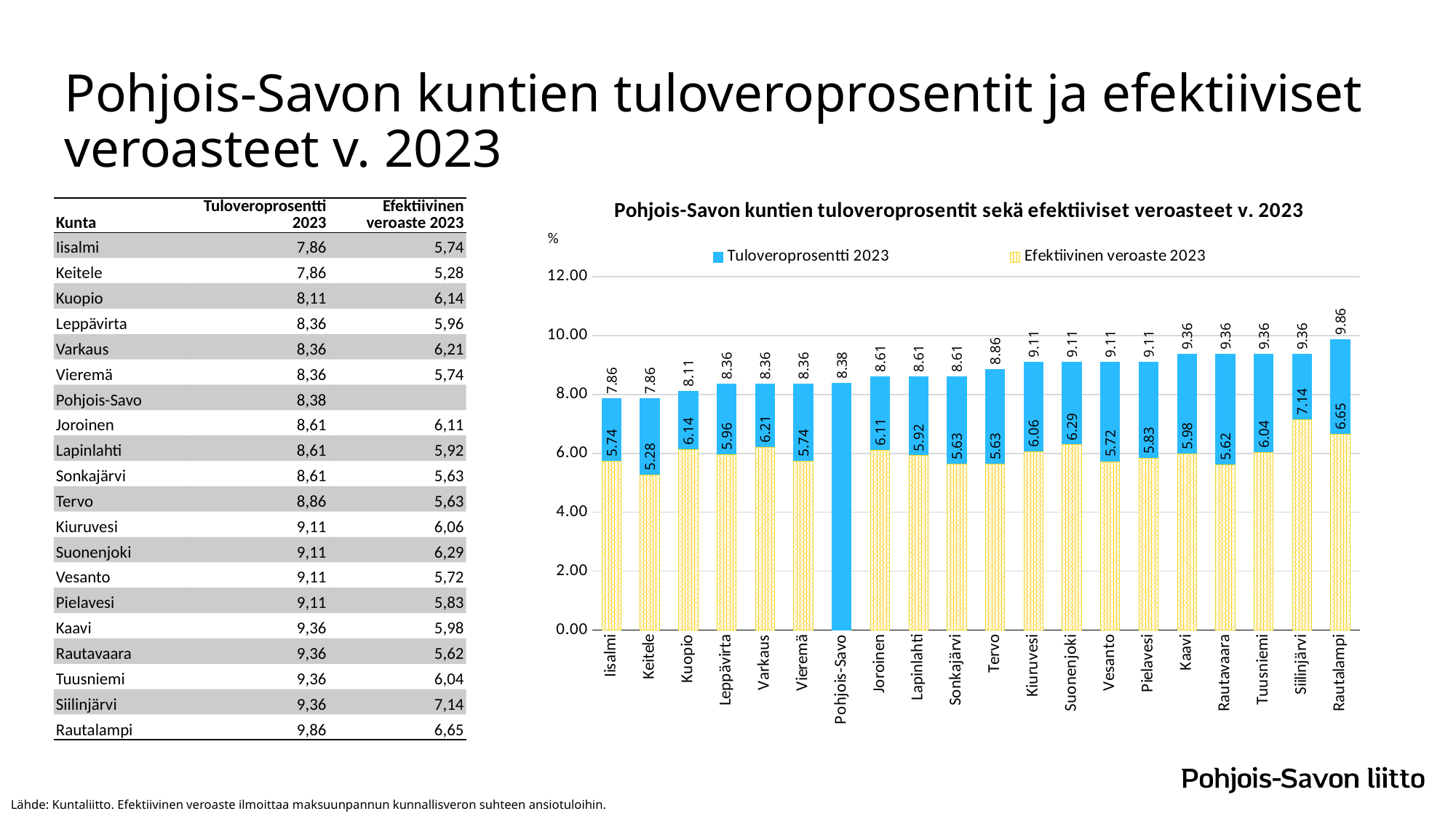
Which has a higher Efektiivinen veroaste 2023, Suonenjoki or Kiuruvesi? Suonenjoki What is the Efektiivinen veroaste 2023 value for Siilinjärvi in the chart? 7.14 Which category has the lowest Efektiivinen veroaste 2023 in the chart? Keitele What is the difference between the Tuloveroprosentti 2023 and the Efektiivinen veroaste 2023 for Rautalampi? 3.21 Which category has the highest Tuloveroprosentti 2023 in the chart? Rautalampi What type of chart is shown on the slide? bar chart Which category has the highest Efektiivinen veroaste 2023 in the chart? Siilinjärvi Do the Tuloveroprosentti 2023 values generally rise or fall from left to right along the x axis? rise How many municipalities/categories are shown on the x axis of the chart? 20 Is the Tuloveroprosentti 2023 value for Pohjois-Savo greater or less than 8.00? greater What is the Tuloveroprosentti 2023 value for Rautalampi in the chart? 9.86 How many series does the chart legend list? 2